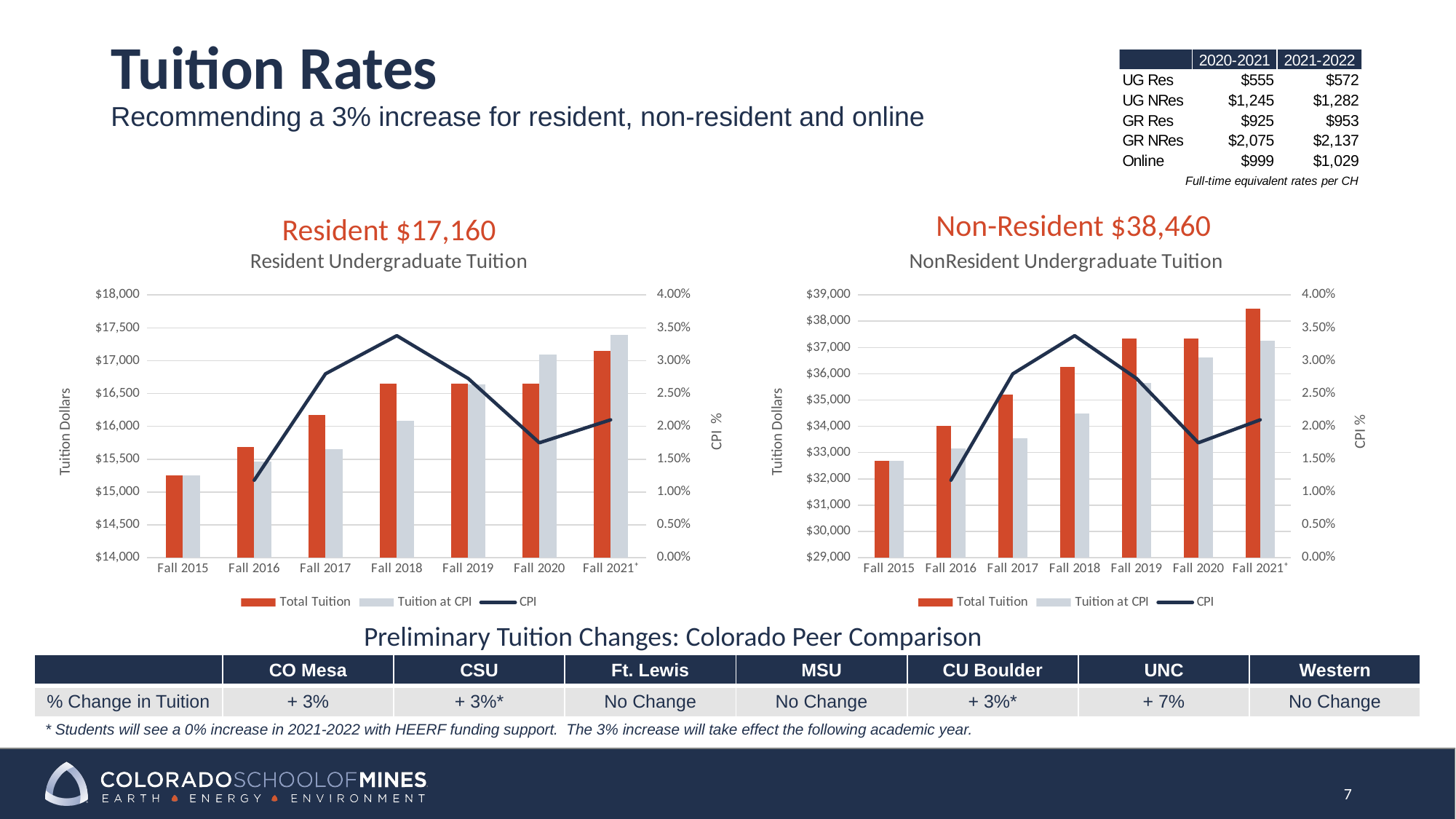
On the NonResident Undergraduate Tuition chart, is the Total Tuition for Fall 2016 greater or less than $35,000? less On the NonResident Undergraduate Tuition chart, does the CPI line rise or fall from Fall 2016 to Fall 2018? rise On the Resident Undergraduate Tuition chart, how many series does the legend list? 3 On the Resident Undergraduate Tuition chart, is the Total Tuition for Fall 2017 greater or less than $16,000? greater On the Resident Undergraduate Tuition chart, which fall term has the lowest Total Tuition bar? Fall 2015 On the Resident Undergraduate Tuition chart, which fall term has the highest Total Tuition bar? Fall 2021 On the NonResident Undergraduate Tuition chart, is the Total Tuition for Fall 2021 greater or less than $38,000? greater On the NonResident Undergraduate Tuition chart, for Fall 2018, which is larger: Total Tuition or Tuition at CPI? Total Tuition On the Resident Undergraduate Tuition chart, how many fall terms are shown on the x axis? 7 On the Resident Undergraduate Tuition chart, for Fall 2020, which is larger: Total Tuition or Tuition at CPI? Tuition at CPI On the NonResident Undergraduate Tuition chart, which fall term has the highest Total Tuition bar? Fall 2021 On the Resident Undergraduate Tuition chart, what kind of chart is it? bar chart with a line